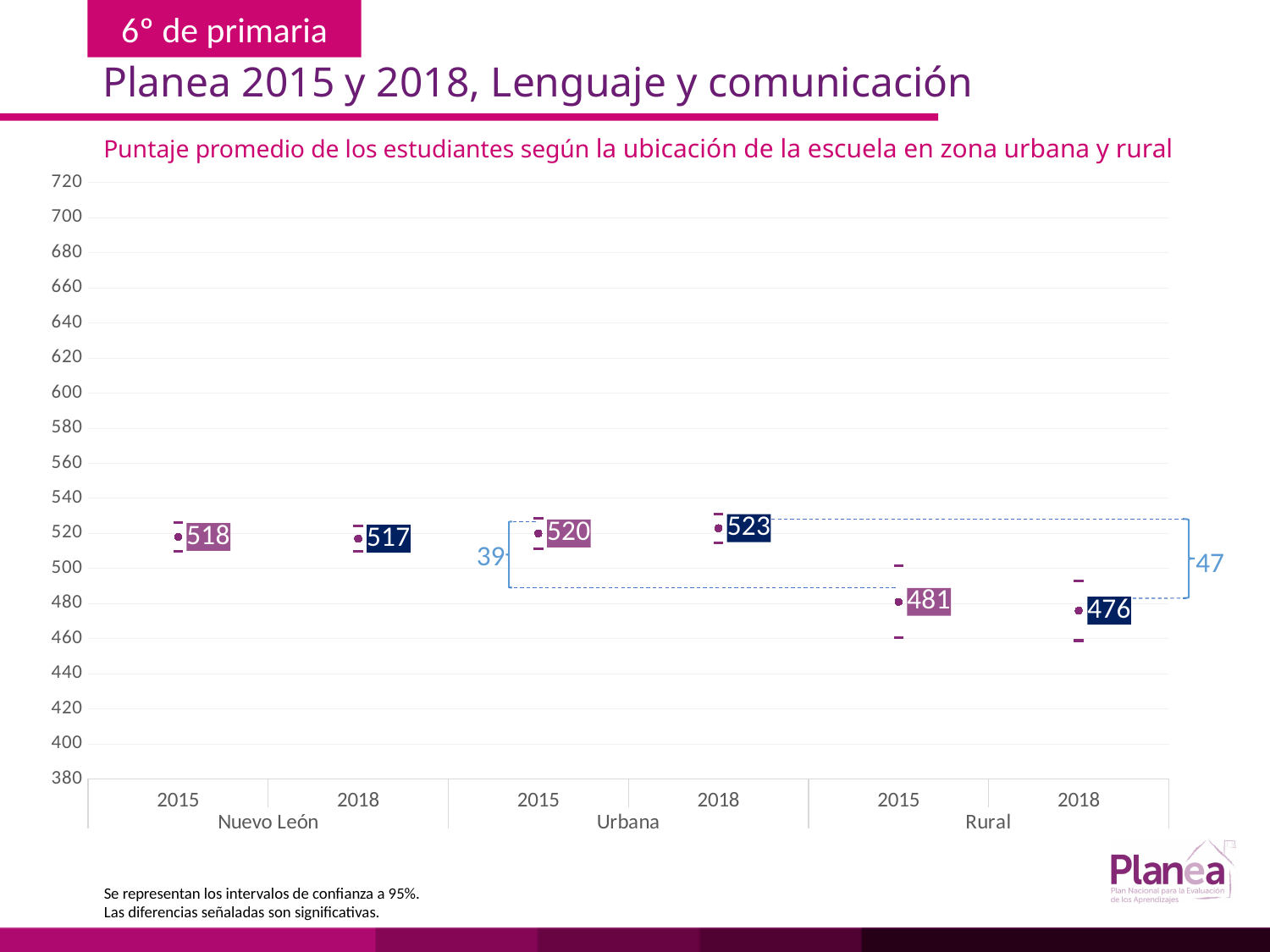
What is the average score for Nuevo León in 2015? 518 What is the difference between the Urbana and Rural average scores in 2018? 47 What is the average score for Rural in 2018? 476 Which category and year has the lowest average score? Rural 2018 Which is larger, the Nuevo León score in 2015 or the Rural score in 2015? Nuevo León 2015 What is the subtitle of the chart? Puntaje promedio de los estudiantes según la ubicación de la escuela en zona urbana y rural What is the average score for Urbana in 2018? 523 What is the average score for Rural in 2015? 481 Which category and year has the highest average score? Urbana 2018 What is the difference between the Urbana and Rural average scores in 2015? 39 How many data points are plotted on the chart? 6 Did the Rural average score rise or fall from 2015 to 2018? fall